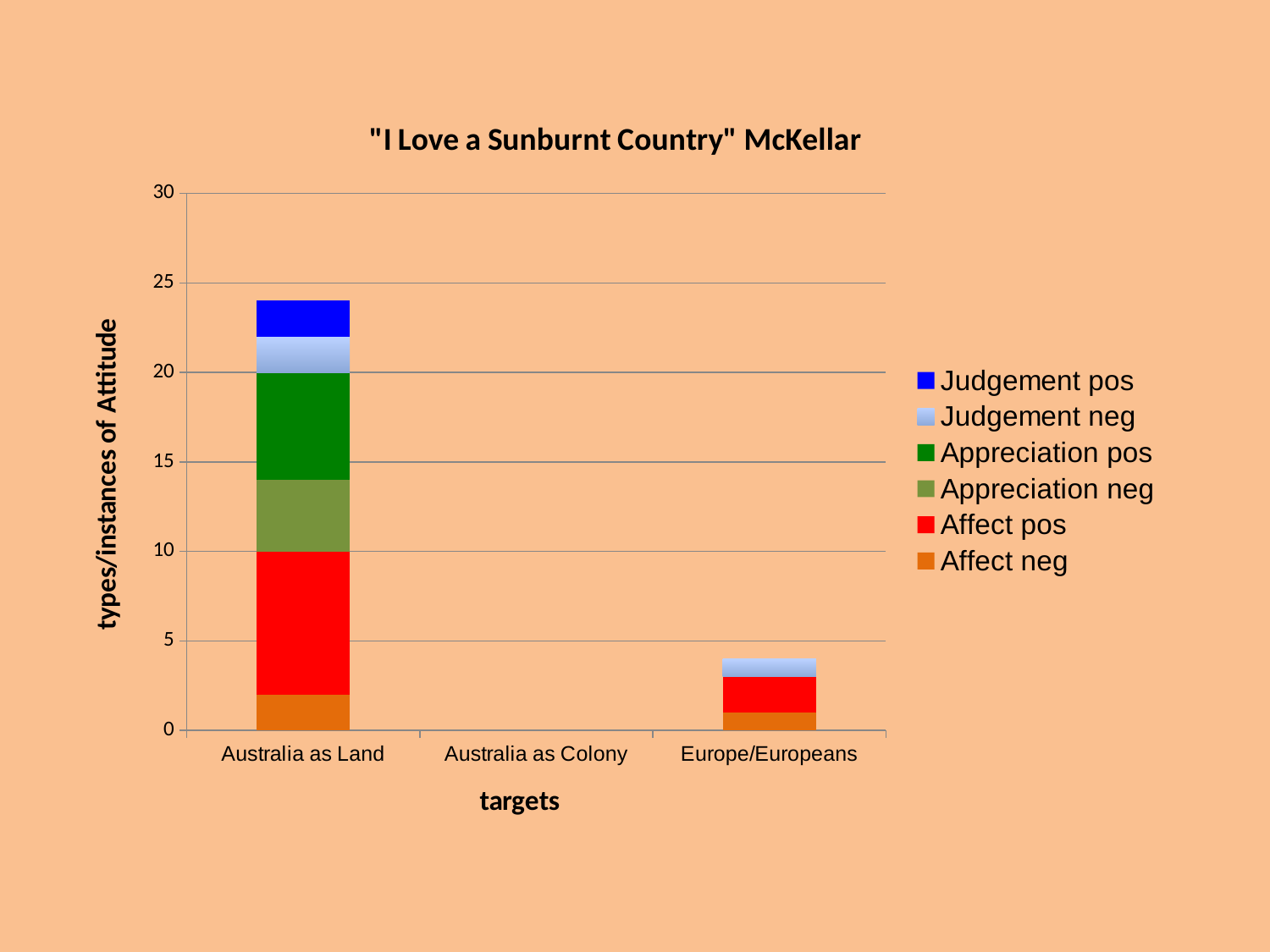
Which target has the tallest stacked bar? Australia as Land What is the title of the chart? "I Love a Sunburnt Country" McKellar What is the label on the y axis? types/instances of Attitude Is the total stacked value for Australia as Land greater or less than 25? less How many target categories are shown on the x axis? 3 What kind of chart is shown on the slide? Stacked bar chart Is the total stacked value for Australia as Land greater or less than 20? greater Which target has a larger total, Australia as Land or Europe/Europeans? Australia as Land How many series does the legend list? 6 Which target has the smallest total, with no visible bar? Australia as Colony Is the Affect pos segment for Australia as Land greater or less than 5? greater